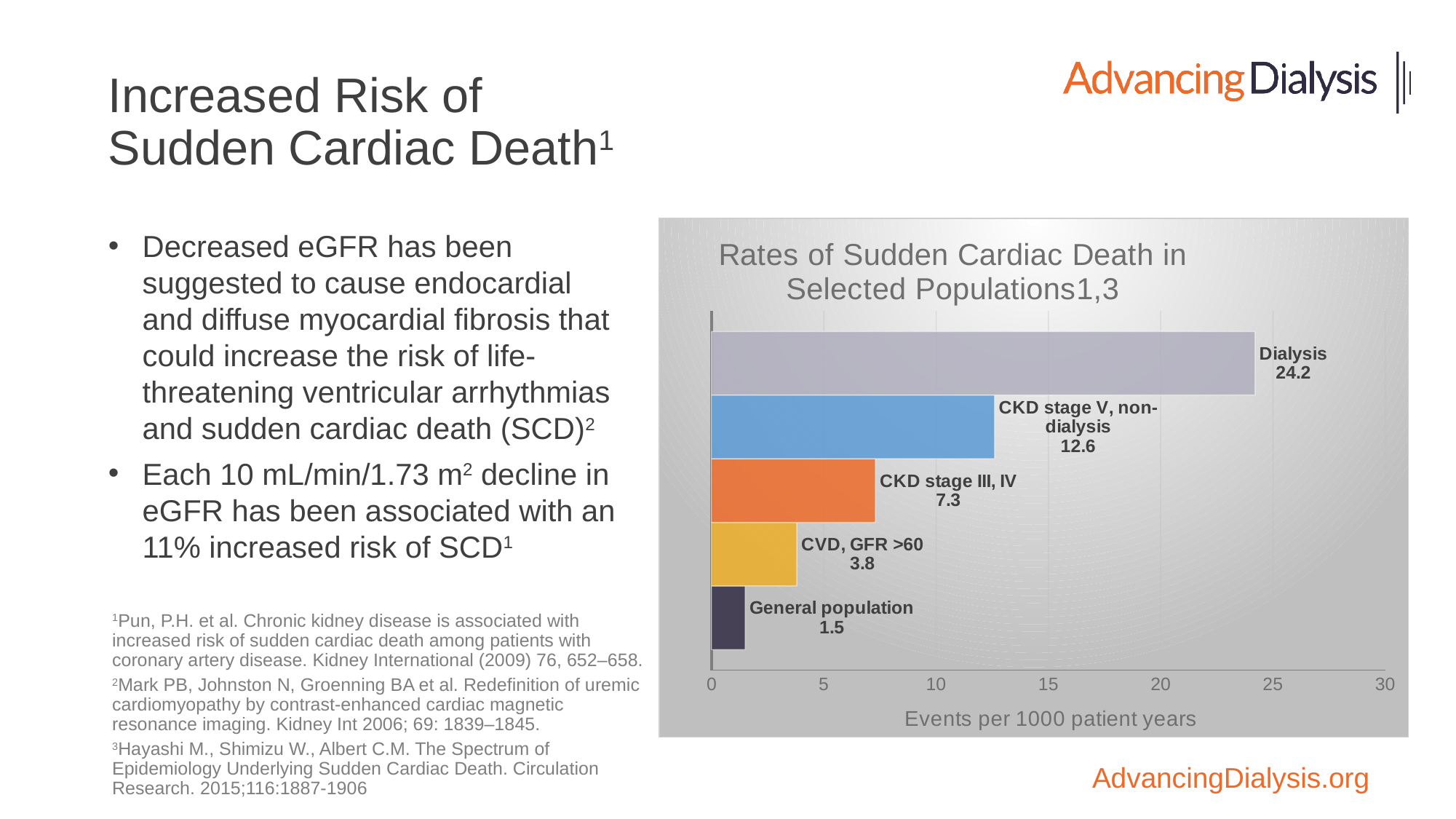
Which category has the lowest rate of sudden cardiac death? General population Which category has the highest rate of sudden cardiac death? Dialysis Which is larger, the value for CKD stage III, IV or the value for CVD, GFR >60? CKD stage III, IV Is the value for Dialysis greater or less than 20? greater What is the label of the x axis of the chart? Events per 1000 patient years How many categories are shown in the chart? 5 What kind of chart is shown on the slide? Bar chart What is the difference between the values for CKD stage III, IV and CVD, GFR >60? 3.5 What is the value for CKD stage V, non-dialysis? 12.6 What is the value for Dialysis? 24.2 What is the value for General population? 1.5 What is the difference between the values for Dialysis and CKD stage V, non-dialysis? 11.6